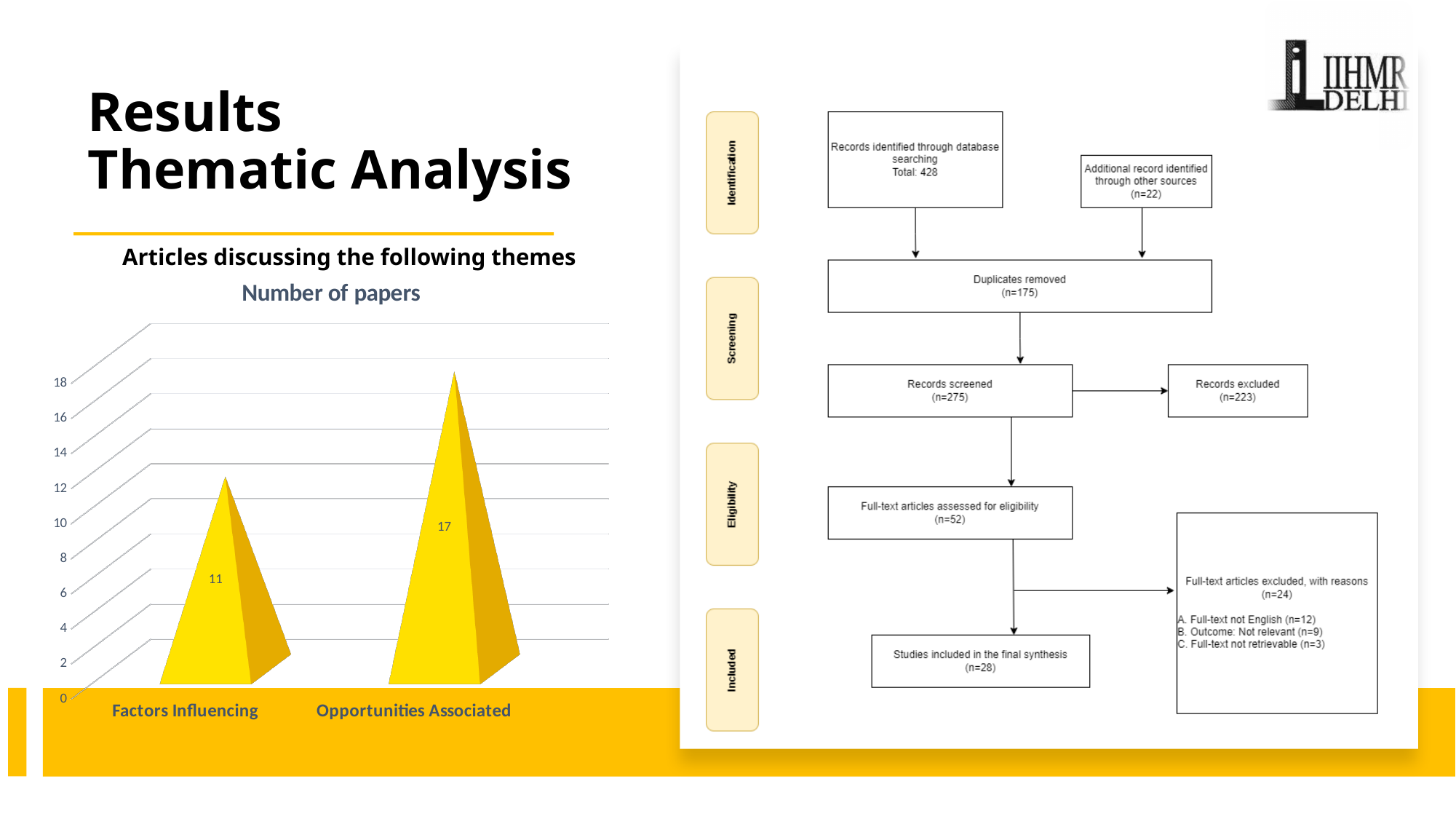
What is the title of the chart on the left of the slide? Number of papers Is the value for Factors Influencing greater or less than 12? less What is the value for Factors Influencing in the Number of papers chart? 11 Is the value for Opportunities Associated greater or less than 16? greater Which category has the lowest number of papers? Factors Influencing Which category has the highest number of papers? Opportunities Associated Which has more papers, Factors Influencing or Opportunities Associated? Opportunities Associated What is the maximum value shown on the vertical axis of the Number of papers chart? 18 What is the value for Opportunities Associated in the Number of papers chart? 17 What kind of chart is used to show the number of papers? Bar chart How many categories are shown in the Number of papers chart? 2 What is the difference in number of papers between Opportunities Associated and Factors Influencing? 6